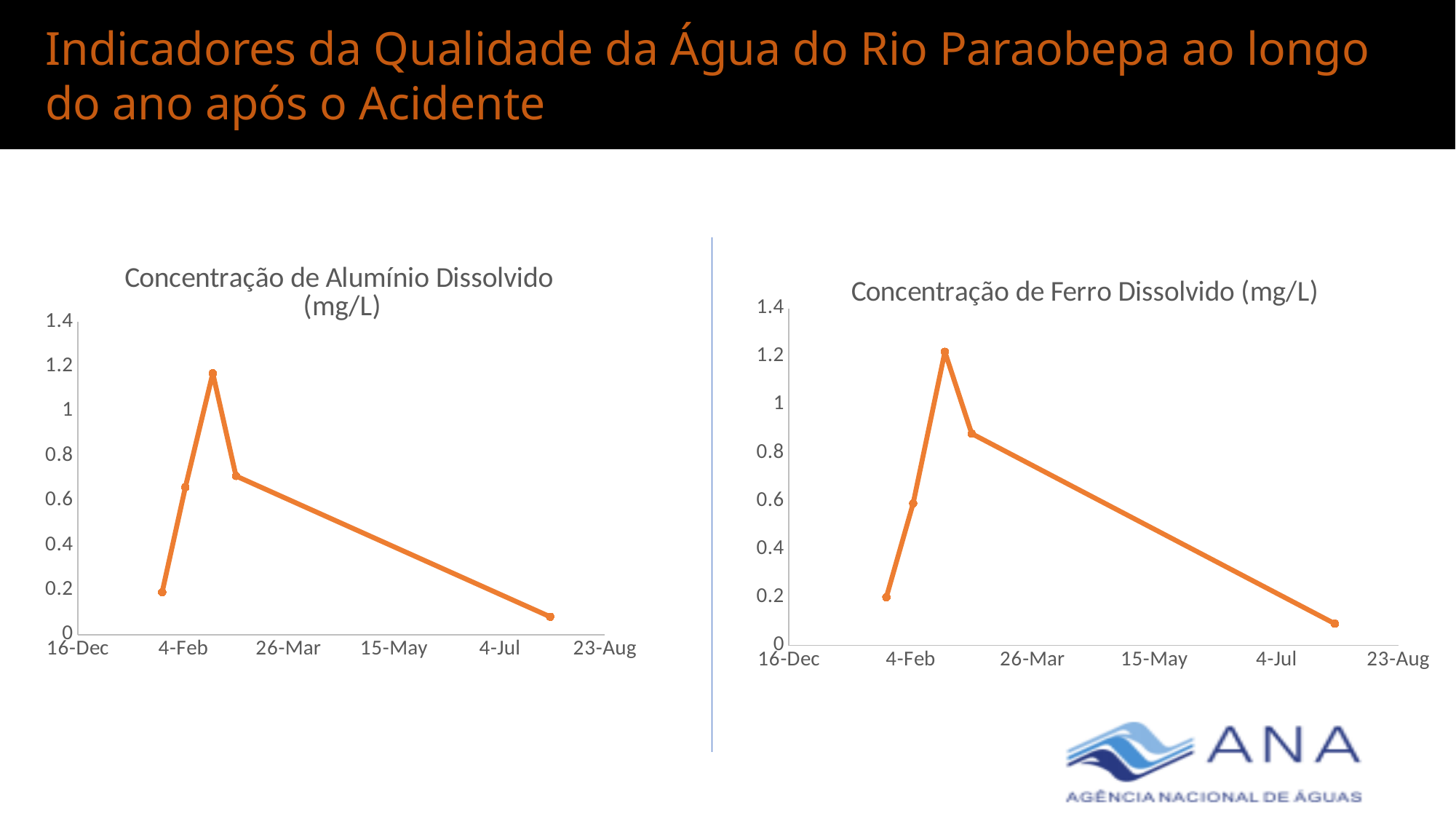
On the 'Concentração de Alumínio Dissolvido (mg/L)' chart, which is larger: the first plotted value (late January) or the peak value (February)? the peak value (February) What kind of chart is the 'Concentração de Ferro Dissolvido (mg/L)' chart? line chart What is the title of the chart on the right side of the slide? Concentração de Ferro Dissolvido (mg/L) How many data points are plotted on the 'Concentração de Alumínio Dissolvido (mg/L)' chart? 5 How many data points are plotted on the 'Concentração de Ferro Dissolvido (mg/L)' chart? 5 On the 'Concentração de Ferro Dissolvido (mg/L)' chart, is the fourth plotted value (just before 26-Mar) greater or less than 0.8? greater On the 'Concentração de Alumínio Dissolvido (mg/L)' chart, is the fourth plotted value (just before 26-Mar) greater or less than 0.8? less On the 'Concentração de Alumínio Dissolvido (mg/L)' chart, is the last plotted value (near mid-July) greater or less than 0.2? less What kind of chart is the 'Concentração de Alumínio Dissolvido (mg/L)' chart? line chart On the 'Concentração de Ferro Dissolvido (mg/L)' chart, do the values rise or fall between the peak in February and the last point in July? fall